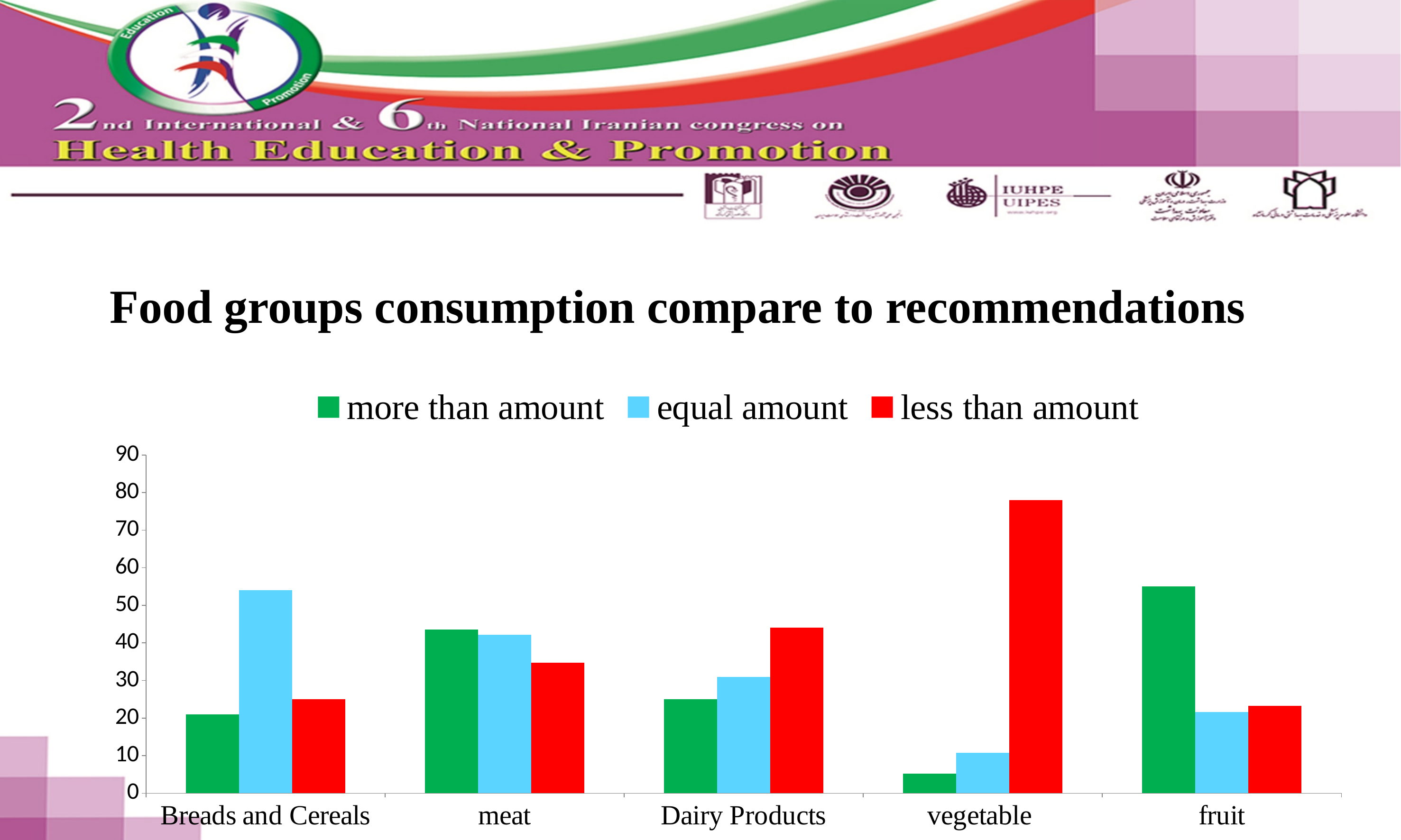
Which food group has the highest value for "more than amount"? fruit What colour represents the "less than amount" series? red How many food groups are shown on the x axis? 5 Which food group has the highest value for "equal amount"? Breads and Cereals What kind of chart is shown on the slide? bar chart How many series does the legend list? 3 Is the "less than amount" value for vegetable greater or less than 70? greater Is the "equal amount" value for Breads and Cereals greater or less than 50? greater Which food group has the highest value for "less than amount"? vegetable Is the "more than amount" value for vegetable greater or less than 10? less Which food group has the lowest value for "more than amount"? vegetable For Dairy Products, which is larger: "less than amount" or "more than amount"? less than amount